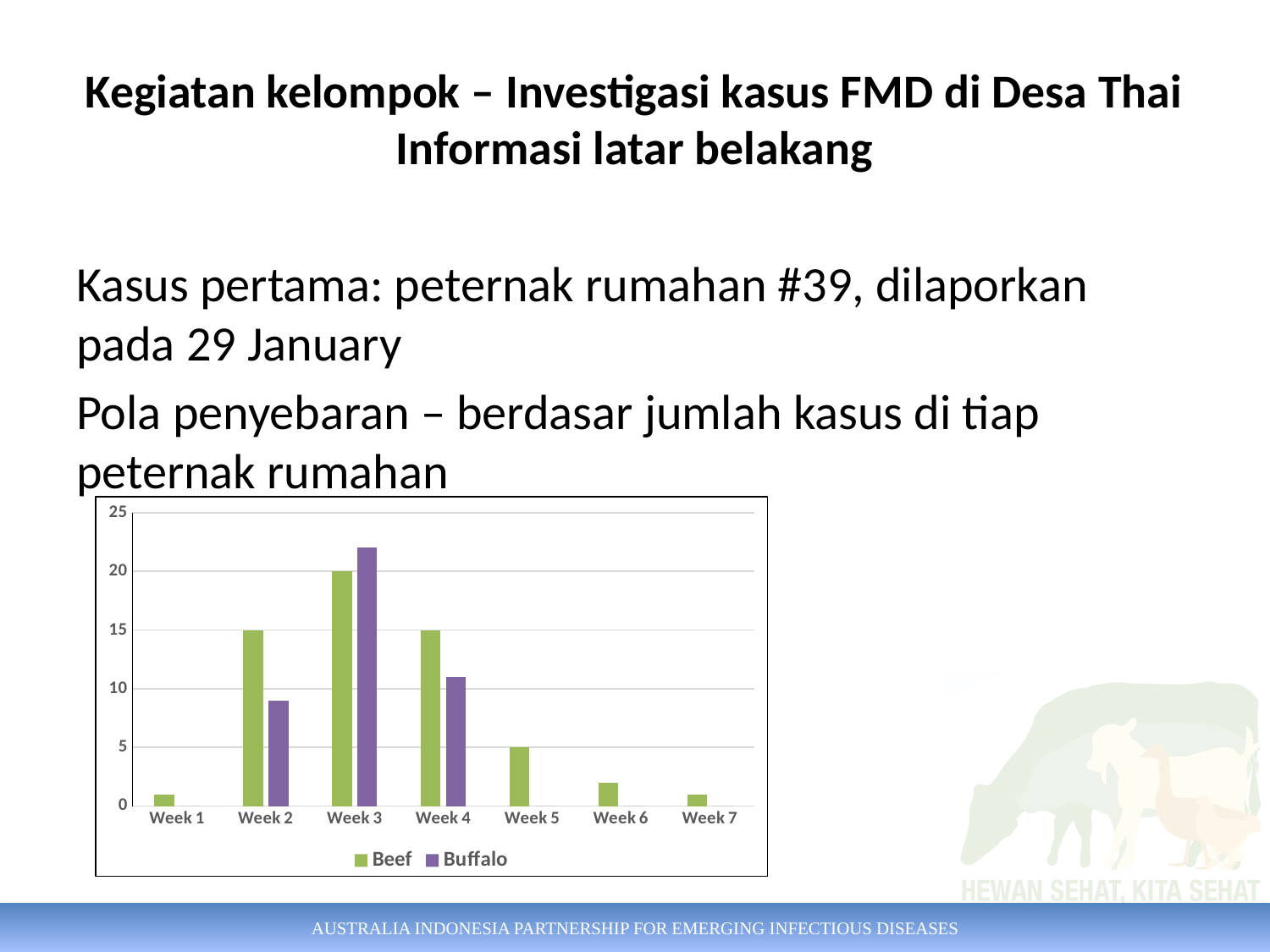
How many weeks are shown on the x axis of the chart? 7 What is the Beef value for Week 3? 20 What is the Beef value for Week 5? 5 In Week 3, which is larger, Beef or Buffalo? Buffalo What is the difference between the Beef values for Week 3 and Week 5? 15 In which week is the Buffalo value highest? Week 3 In which week is the Beef value highest? Week 3 Is the Buffalo value for Week 2 greater or less than 10? less What kind of chart is shown on the slide? bar chart Is the Buffalo value for Week 3 greater or less than 20? greater How many series does the chart legend list? 2 In Week 2, which is larger, Beef or Buffalo? Beef